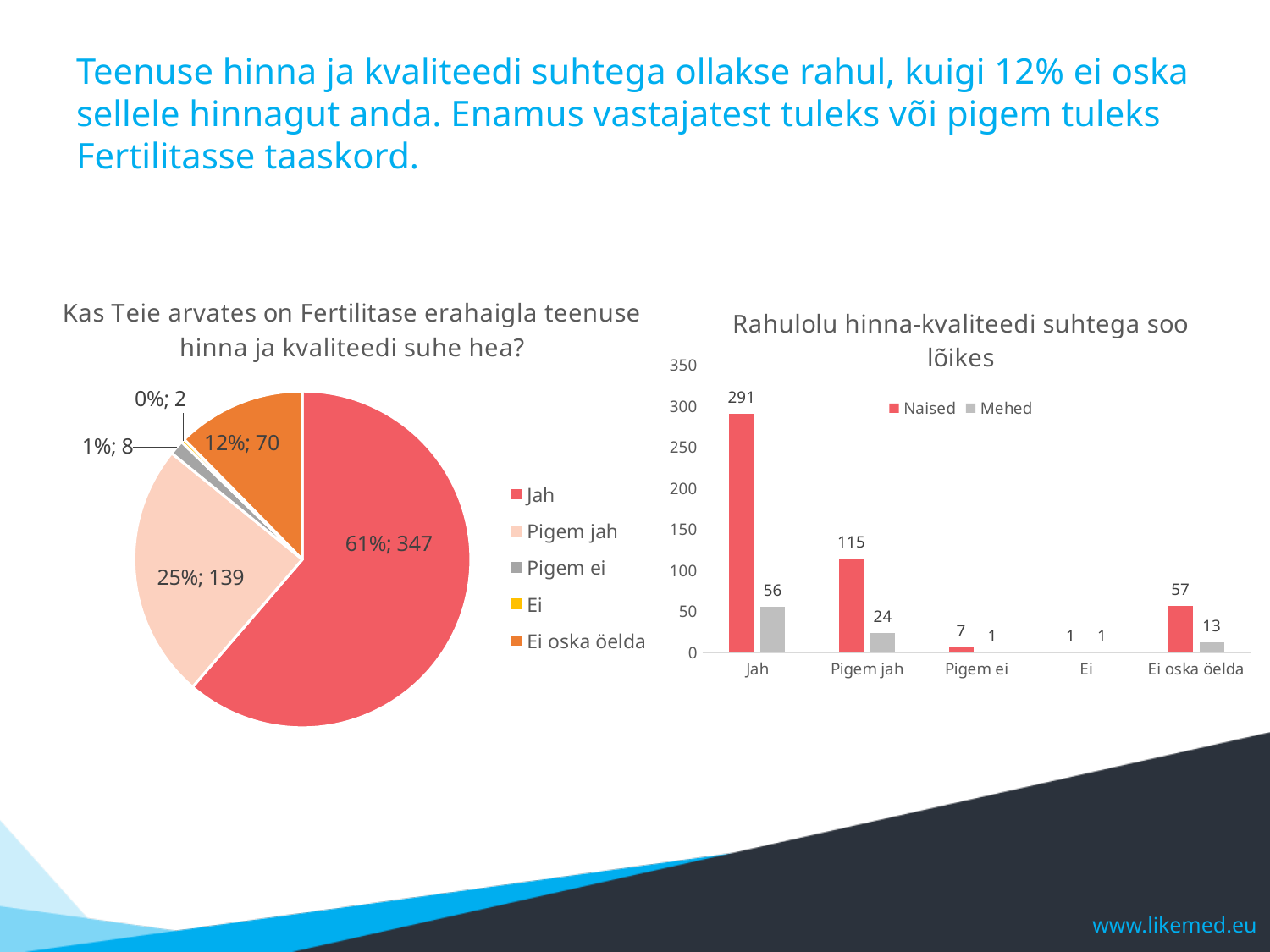
In the bar chart on the right, what is the difference between Naised and Mehed in the 'Jah' category? 235 In the bar chart on the right, which category has the highest value for Naised? Jah In the pie chart on the left, what is the count shown for 'Pigem jah'? 139 In the pie chart on the left, how many categories does the legend list? 5 In the pie chart on the left, which category has the smallest slice? Ei What kind of chart is the chart on the right of the slide? Bar chart In the bar chart on the right, how many series does the legend list? 2 In the pie chart on the left, what share is shown for 'Ei oska öelda'? 12% In the bar chart 'Rahulolu hinna-kvaliteedi suhtega soo lõikes', what is the value for Mehed in the 'Pigem jah' category? 24 In the pie chart 'Kas Teie arvates on Fertilitase erahaigla teenuse hinna ja kvaliteedi suhe hea?', what share of the pie does 'Jah' have? 61% In the bar chart on the right, which is larger: Mehed for 'Jah' or Mehed for 'Ei oska öelda'? Mehed for 'Jah' In the bar chart 'Rahulolu hinna-kvaliteedi suhtega soo lõikes', what is the value for Naised in the 'Jah' category? 291